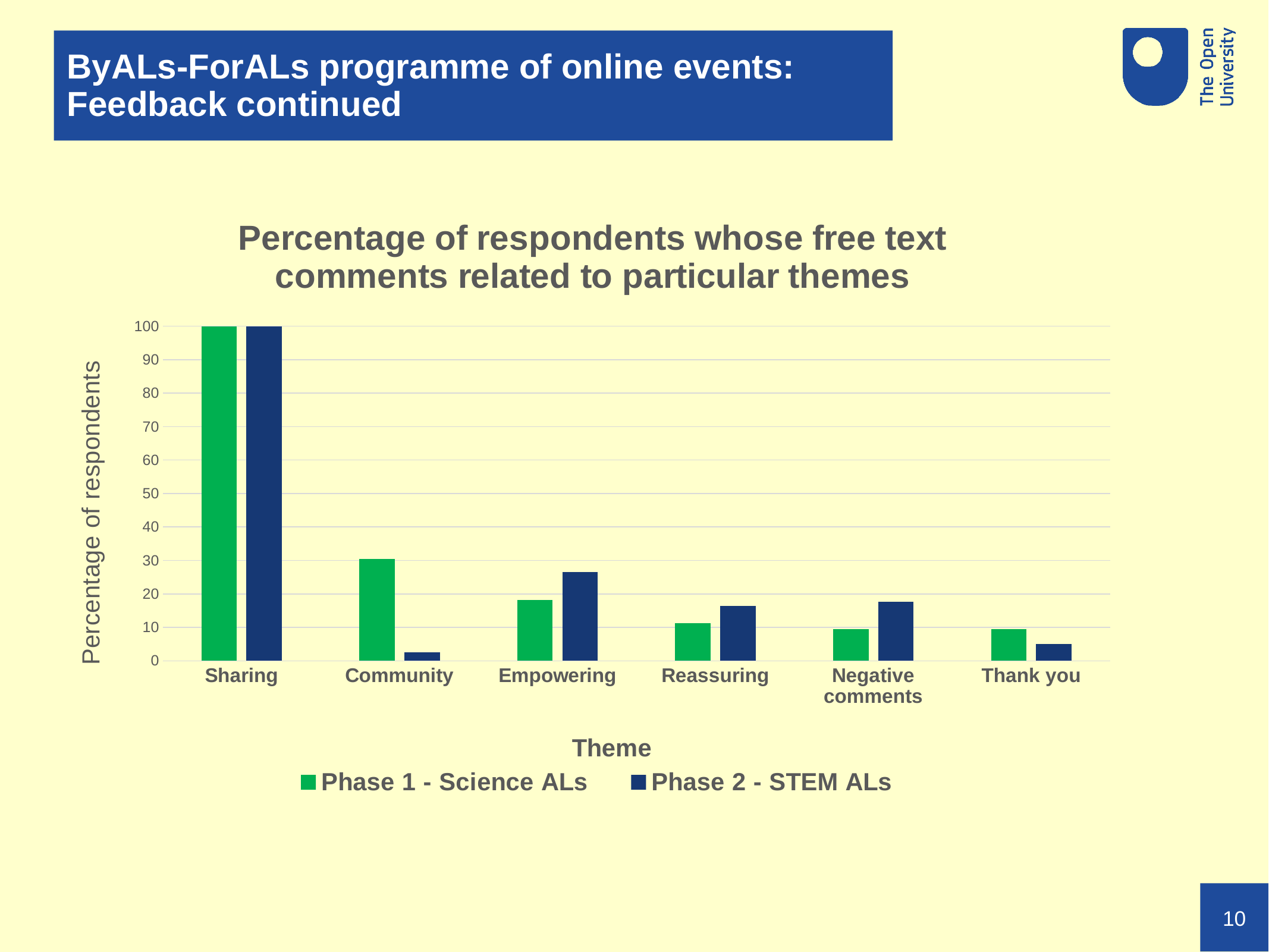
How many series does the chart's legend list? 2 What kind of chart is shown on the slide? Bar chart For the Empowering theme, which series has the larger value: Phase 1 - Science ALs or Phase 2 - STEM ALs? Phase 2 - STEM ALs For the Community theme, which series has the larger value: Phase 1 - Science ALs or Phase 2 - STEM ALs? Phase 1 - Science ALs How many themes are shown on the x axis of the chart? 6 Which theme has the lowest value for Phase 2 - STEM ALs? Community Which theme has the highest value for Phase 2 - STEM ALs? Sharing What is the value for Sharing in the Phase 1 - Science ALs series? 100 What is the title of the chart's y axis? Percentage of respondents Is the value for Thank you in the Phase 2 - STEM ALs series greater or less than 10? less What is the value for Sharing in the Phase 2 - STEM ALs series? 100 Is the value for Empowering in the Phase 2 - STEM ALs series greater or less than 20? greater